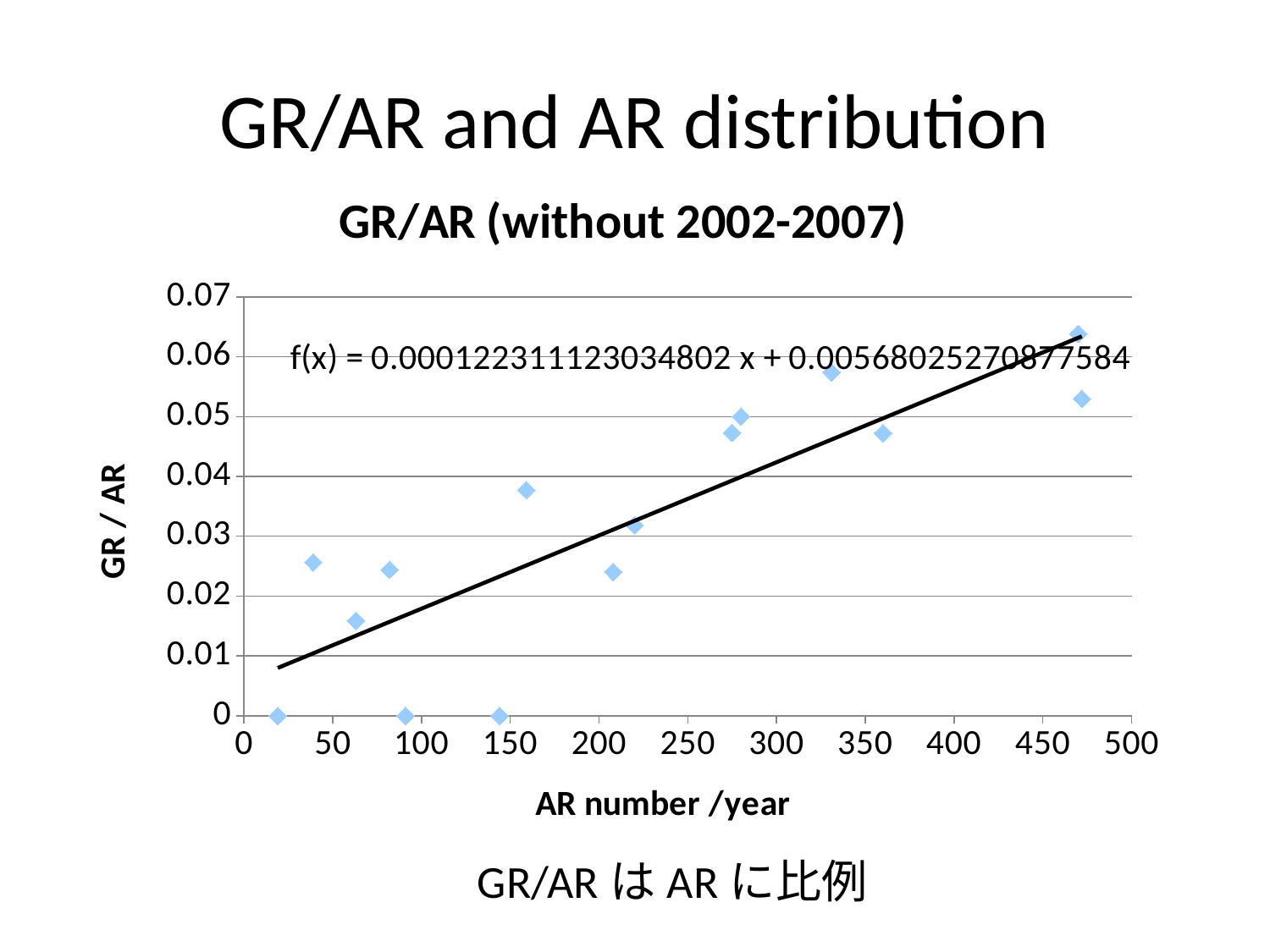
Is the GR/AR value for the point at about 160 AR number /year greater or less than 0.03? greater What is the label of the x axis? AR number /year Which has the larger GR/AR value: the point at about 160 AR number /year or the point at about 208 AR number /year? The point at about 160 Is the GR/AR value for the point at about 330 AR number /year greater or less than 0.05? greater Is the GR/AR value for the point at about 63 AR number /year greater or less than 0.02? less What is the maximum value shown on the y axis? 0.07 What kind of chart is shown on the slide? Scatter chart What is the title of the chart? GR/AR (without 2002-2007) How many data points lie on the GR/AR = 0 line? 3 Do the GR/AR values generally rise or fall as AR number /year increases? Rise